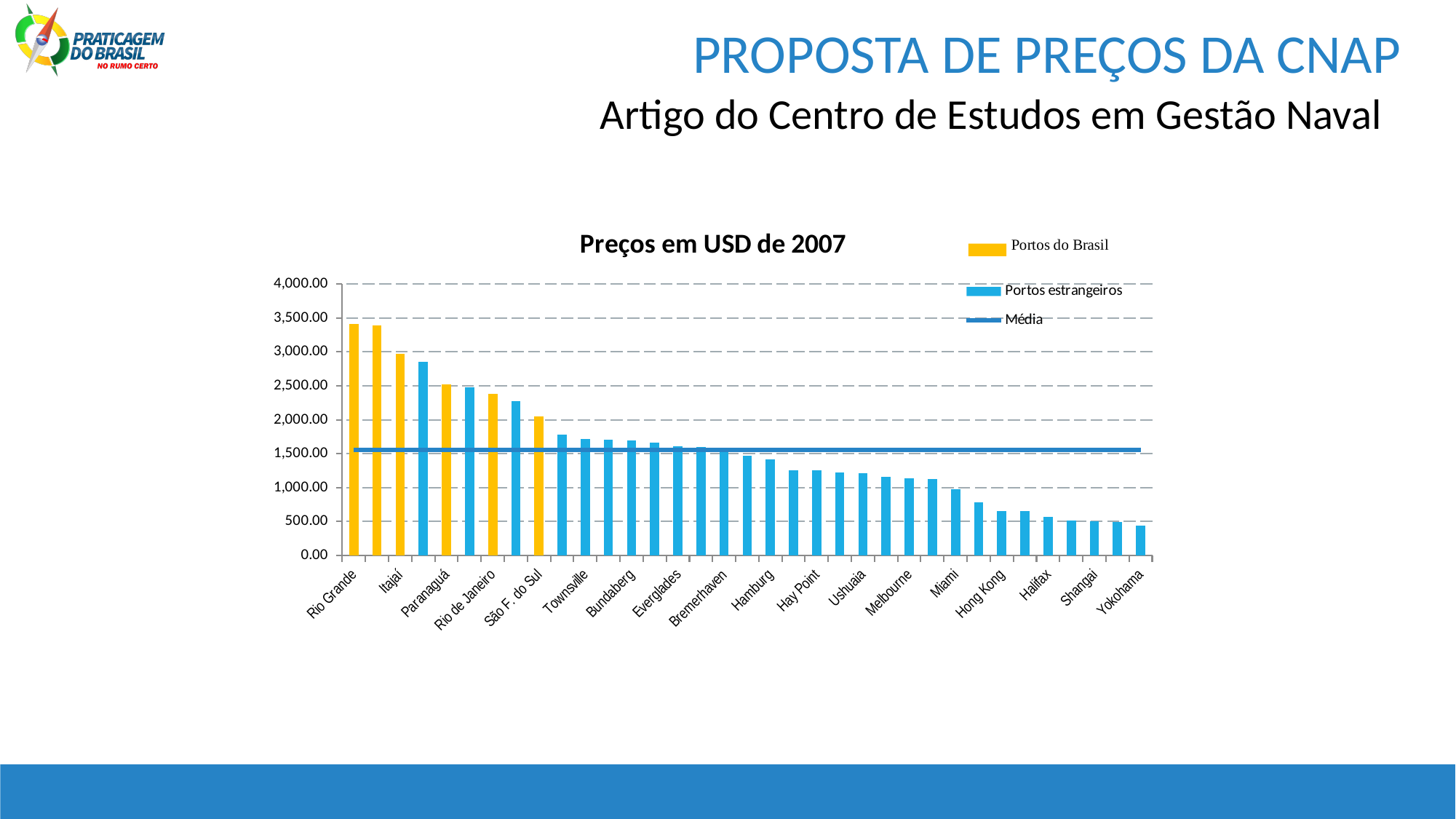
How many entries does the chart legend list? 3 Do the bar values rise or fall from left to right along the x axis? Fall Is the value for Yokohama greater or less than 1,000.00? less Which port has the highest price in the chart? Rio Grande Which legend entry is shown in yellow? Portos do Brasil What is the title of the chart? Preços em USD de 2007 Is the value for Townsville greater or less than 2,000.00? less What kind of chart is shown on the slide? Bar and line chart Is the value for Rio Grande greater or less than 3,000.00? greater Which is larger, the value for Rio Grande or the value for Yokohama? Rio Grande How many port names are labelled on the x axis? 18